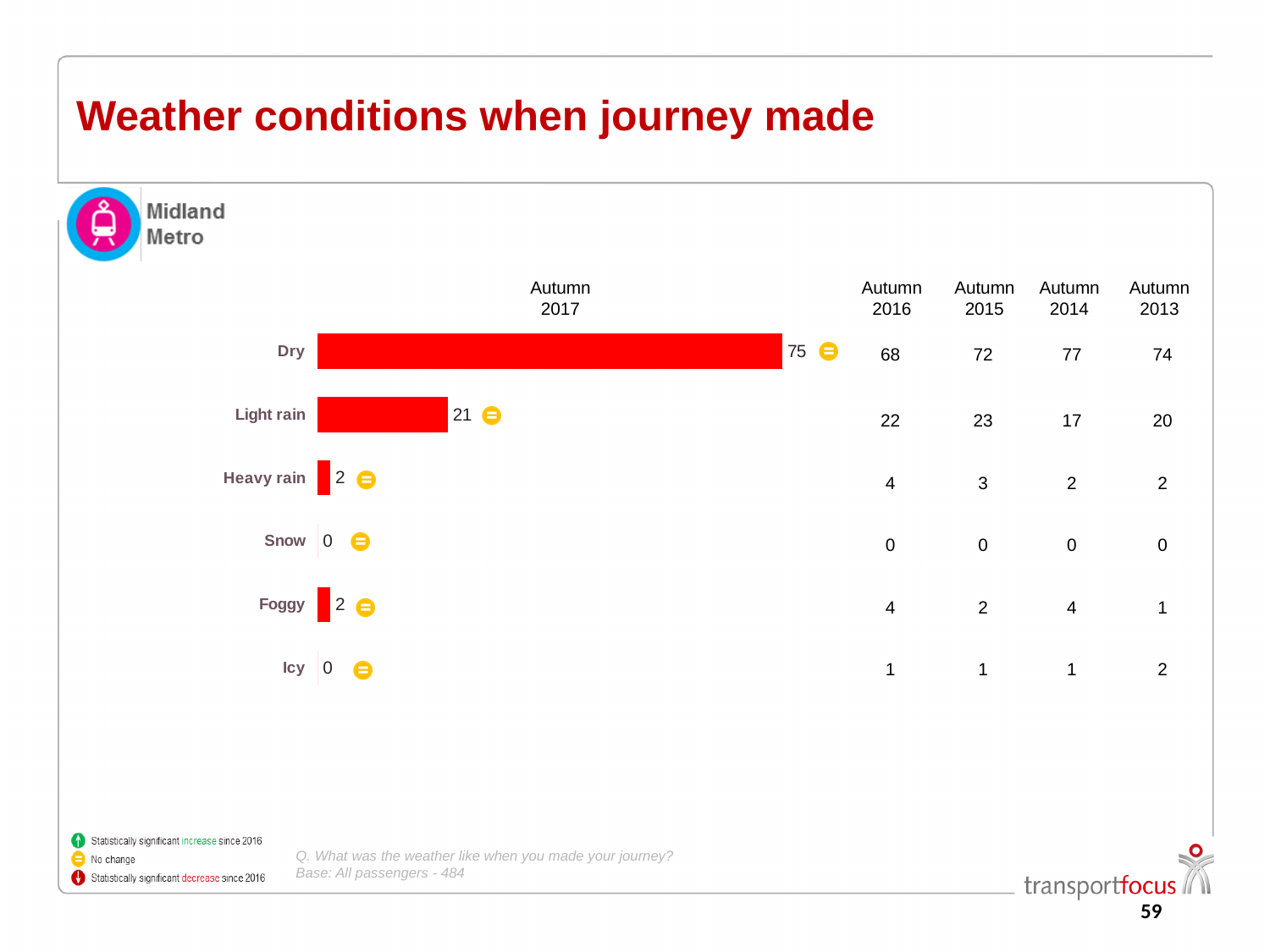
Which weather condition has the highest Autumn 2017 value? Dry What is the difference between the Autumn 2017 values for Heavy rain and Icy? 2 How many weather condition categories are shown in the chart? 6 What is the Autumn 2017 value for Dry? 75 What is the title of the chart? Weather conditions when journey made What is the Autumn 2017 value for Heavy rain? 2 What colour are the bars in the chart? Red Which has a larger Autumn 2017 value, Light rain or Foggy? Light rain What is the Autumn 2017 value for Light rain? 21 What kind of chart is used to show the Autumn 2017 values? Bar chart What is the difference between the Autumn 2017 values for Dry and Light rain? 54 What is the Autumn 2017 value for Snow? 0